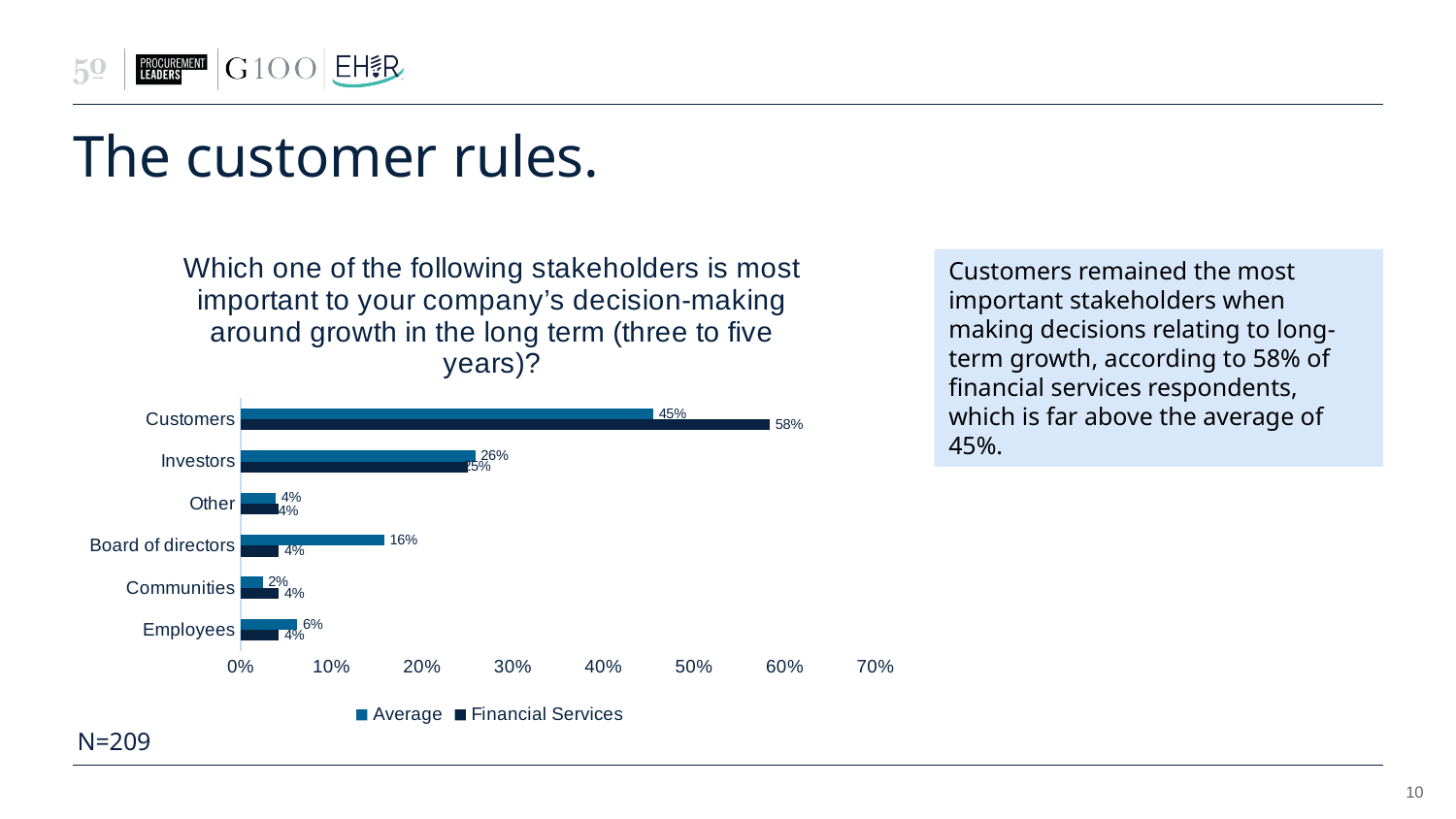
For Board of directors, which is larger: the Average value or the Financial Services value? Average What type of chart is shown on the slide? Bar chart Which stakeholder has the highest Financial Services value? Customers What is the difference between the Financial Services and Average values for Customers? 13% What is the Financial Services value for Employees? 4% Which stakeholder has the lowest Average value? Communities What is the Average value for Customers? 45% What is the Average value for Communities? 2% What is the Financial Services value for Customers? 58% How many stakeholder categories are shown in the chart? 6 What is the Average value for Board of directors? 16% How many series does the legend list? 2